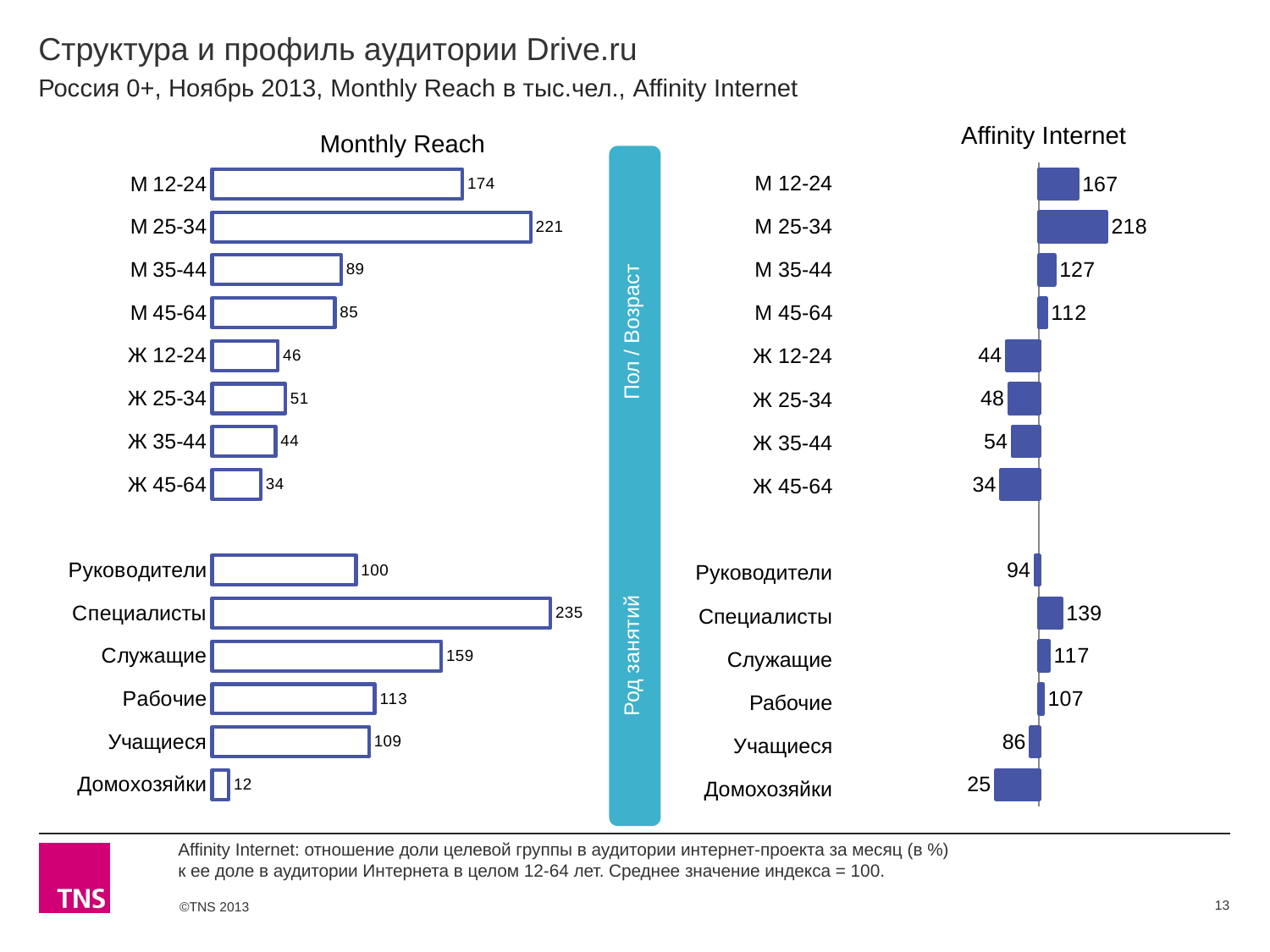
In the Affinity Internet chart, which category has the highest value? М 25-34 In the Monthly Reach chart, what is the difference between Специалисты and Служащие? 76 In the Monthly Reach chart, what is the value for Учащиеся? 109 In the Affinity Internet chart, what is the difference between М 12-24 and М 45-64? 55 In the Monthly Reach chart, how many categories are plotted? 14 In the Monthly Reach chart, which category has the lowest value? Домохозяйки In the Affinity Internet chart, what is the value for Домохозяйки? 25 In the Monthly Reach chart, what is the value for М 25-34? 221 What type of chart is the Affinity Internet chart? Bar chart In the Affinity Internet chart, which category has the lowest value? Домохозяйки In the Affinity Internet chart, which is larger, the value for Ж 35-44 or the value for Ж 12-24? Ж 35-44 In the Monthly Reach chart, which category has the highest value? Специалисты